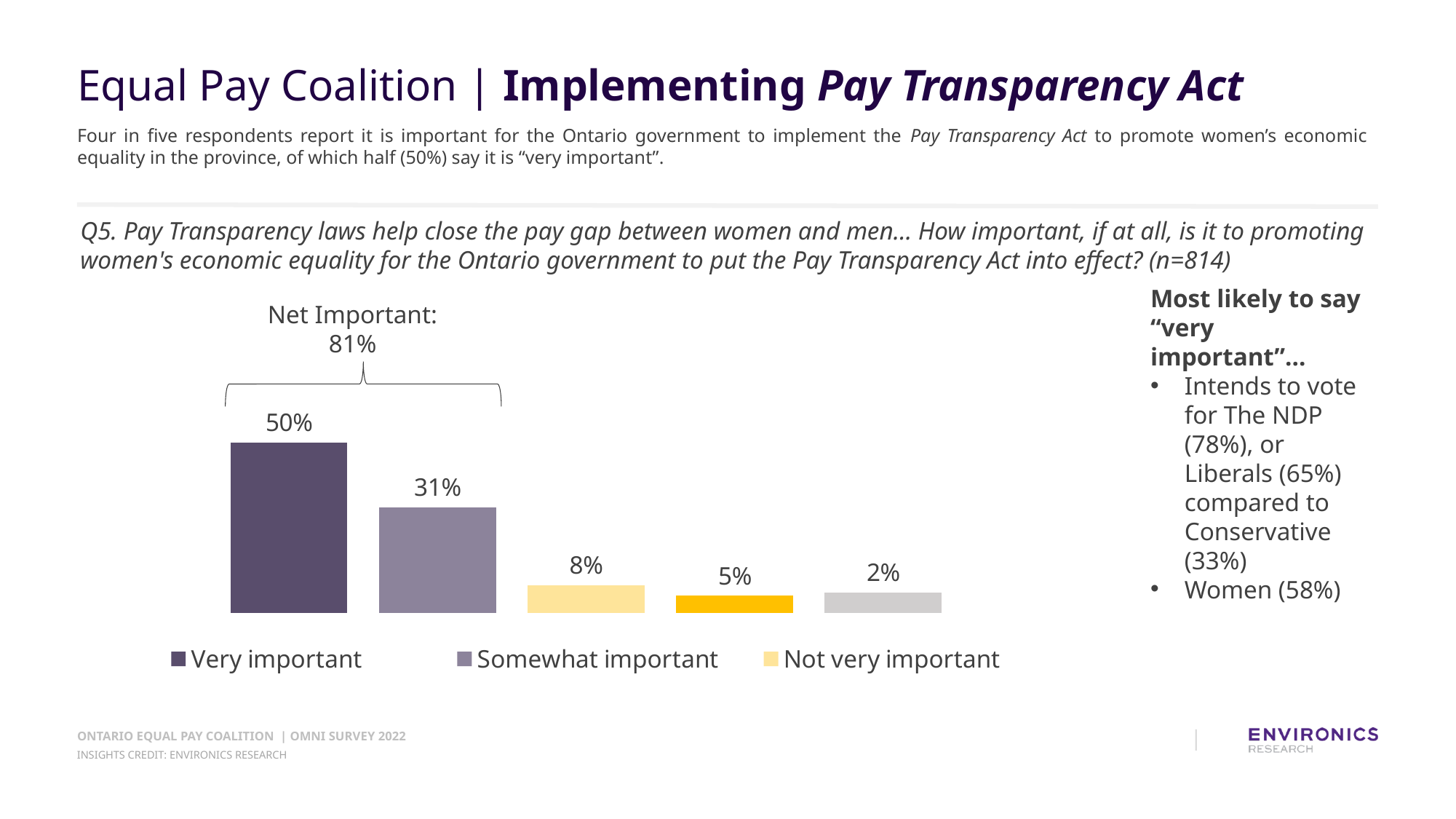
Do the bar values rise or fall from left to right across the chart? Fall What percentage of respondents said it is "very important" for the Ontario government to put the Pay Transparency Act into effect? 50% What type of chart is used on this slide? Bar chart What percentage of respondents said it is "somewhat important"? 31% How many bars are plotted in the chart? 5 How many entries does the chart legend list? 3 Which is larger: the share saying "Somewhat important" or the share saying "Not very important"? Somewhat important Which response category has the highest percentage in the chart? Very important What is the "Net Important" figure shown above the bracket on the chart? 81% What percentage of respondents said it is "not very important"? 8% What is the difference in percentage points between "Very important" and "Somewhat important"? 19 What is the combined percentage of "Very important" and "Somewhat important" responses? 81%